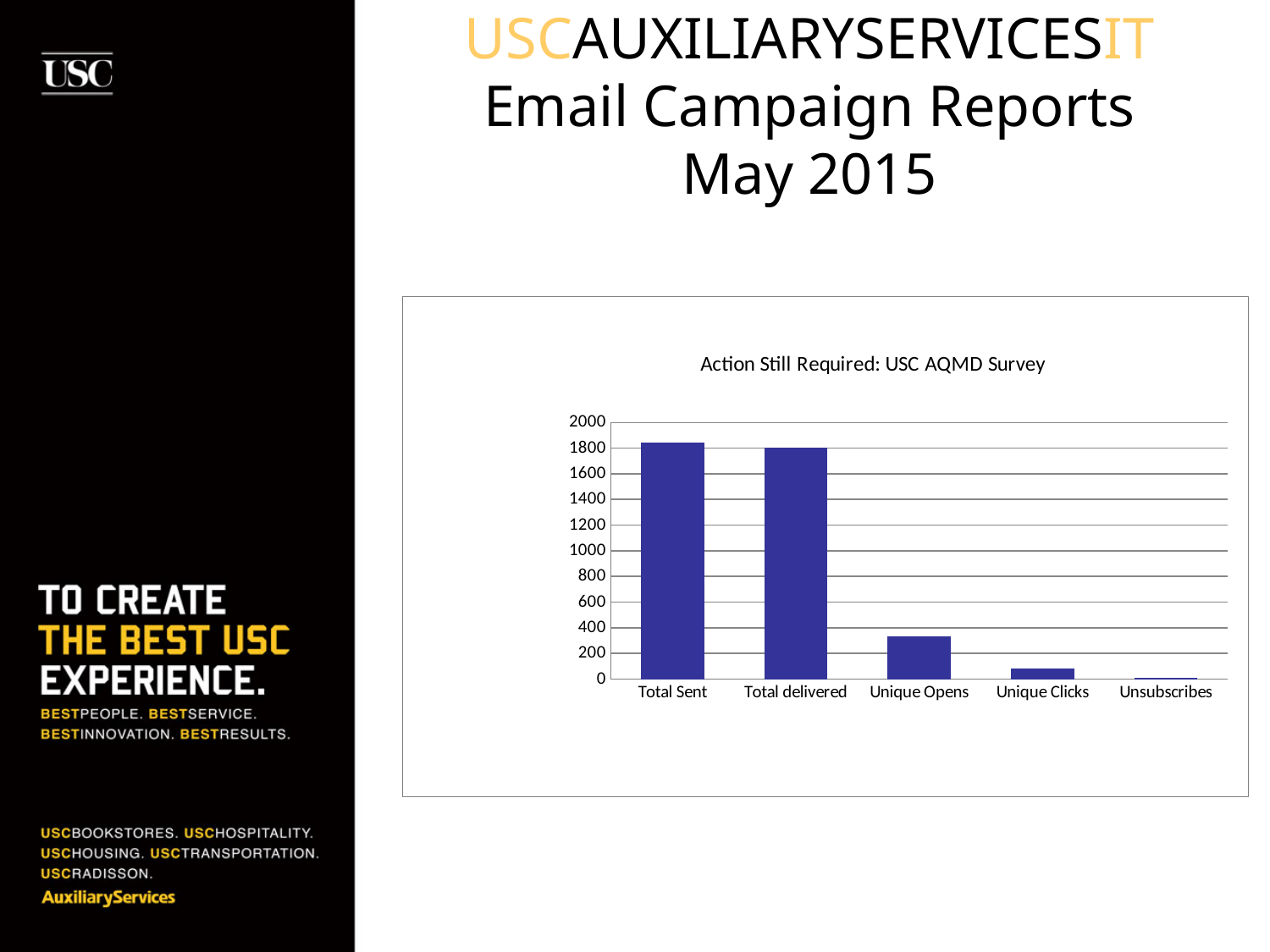
Do the values rise or fall moving from left to right across the categories? Fall Is the value for Unique Clicks greater or less than 200? less Is the value for Total delivered greater or less than 2000? less What is the title of the chart? Action Still Required: USC AQMD Survey Is the value for Unique Opens greater or less than 400? less Which is larger, the value for Unique Opens or the value for Unique Clicks? Unique Opens Which category has the highest value? Total Sent What kind of chart is shown on the slide? Bar chart Which category has the lowest value? Unsubscribes How many categories are plotted on the chart? 5